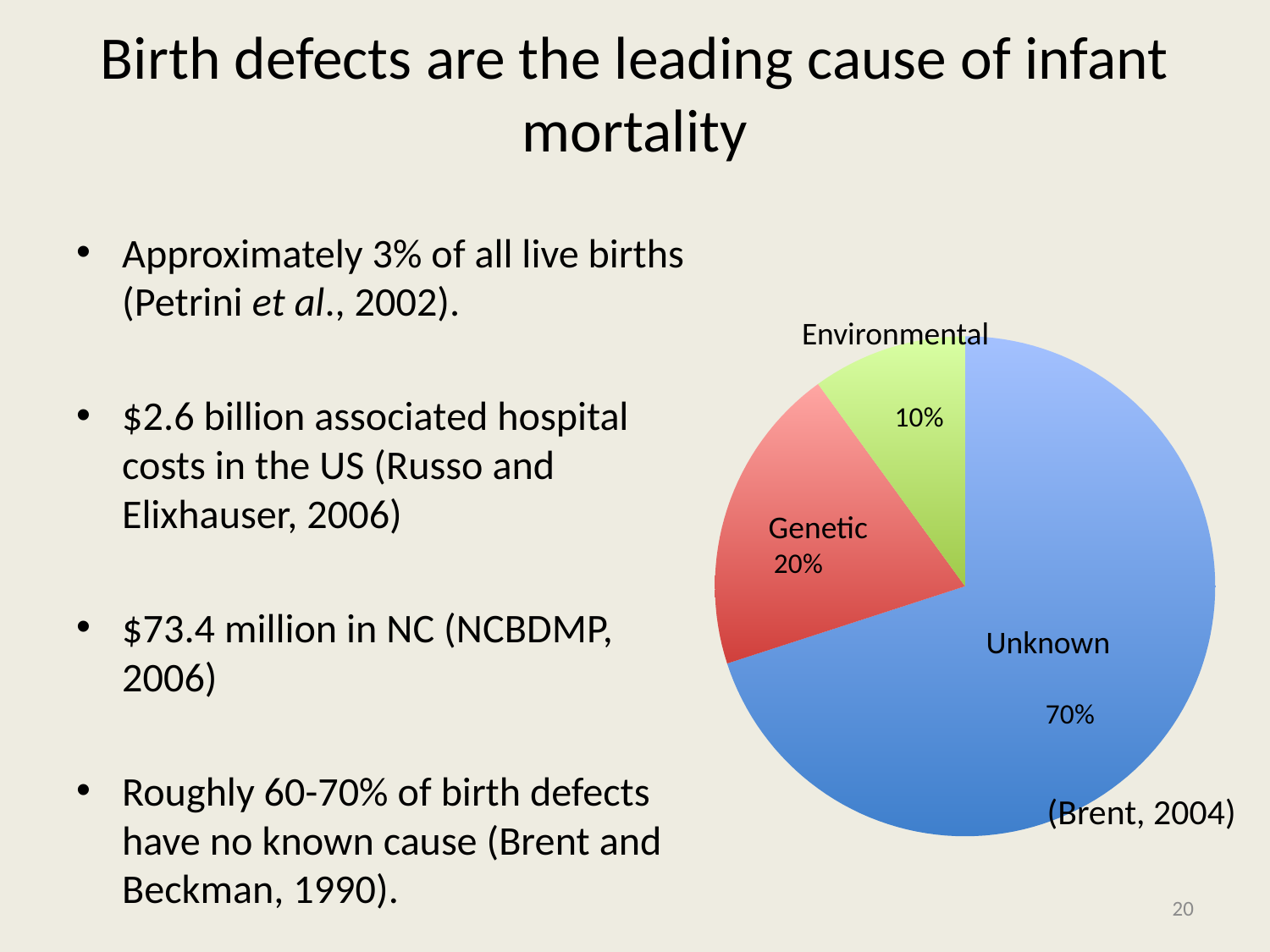
What source citation is printed next to the pie chart? (Brent, 2004) Which slice is larger, Genetic or Environmental? Genetic What share of the pie does the Unknown slice represent? 70% How many slices does the pie chart have? 3 What kind of chart is shown on the slide? pie chart Which category has the largest slice of the pie? Unknown What is the difference in percentage points between the Genetic and Environmental slices? 10% What share of the pie does the Genetic slice represent? 20% What colour is the Unknown slice of the pie? blue Which category has the smallest slice of the pie? Environmental What share of the pie does the Environmental slice represent? 10% What is the difference in percentage points between the Unknown and Genetic slices? 50%